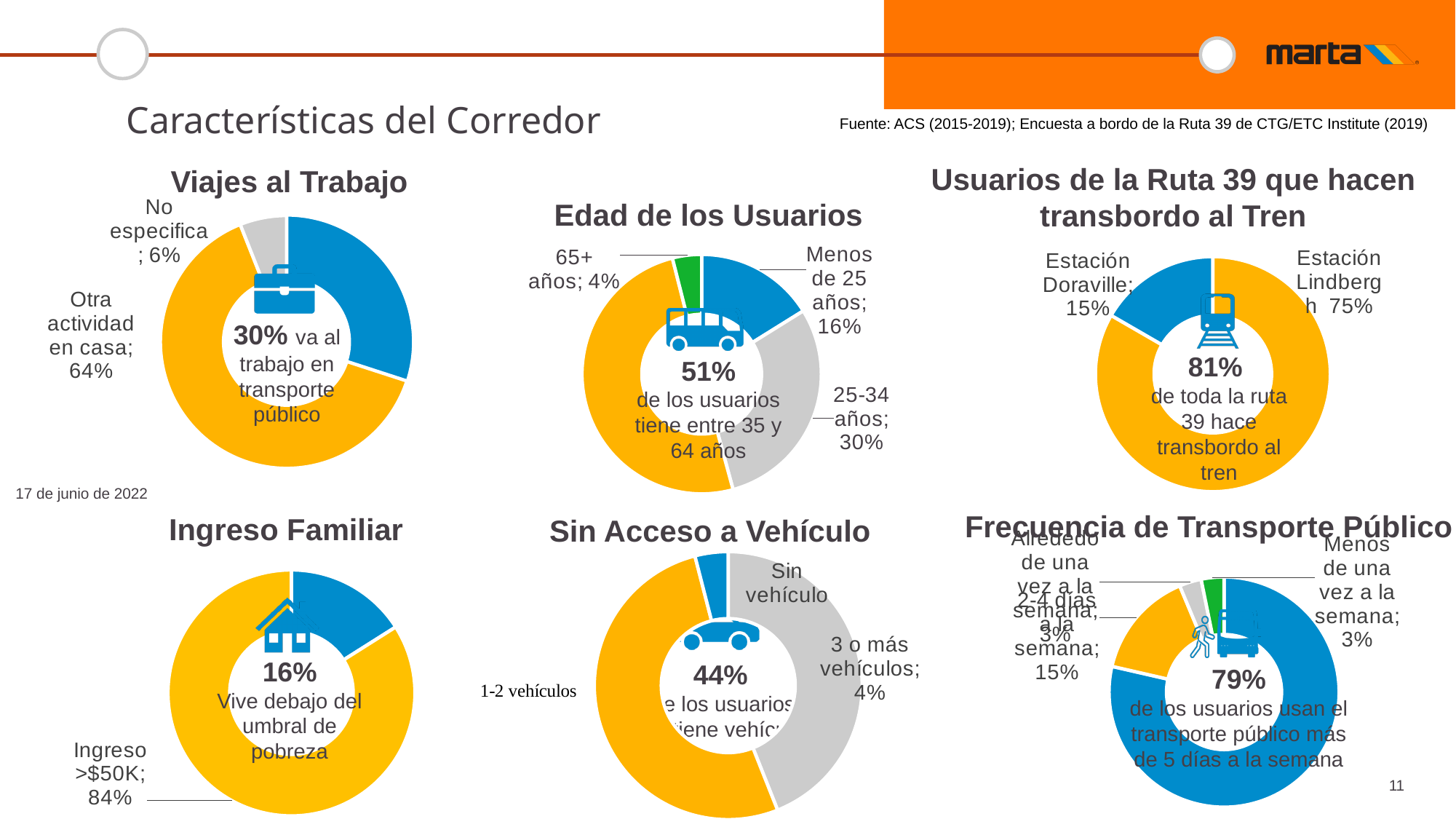
In the 'Usuarios de la Ruta 39 que hacen transbordo al Tren' chart, what percentage is shown for 'Estación Doraville'? 15% In the 'Viajes al Trabajo' chart, what percentage is shown for 'No especifica'? 6% How many slices does the 'Edad de los Usuarios' chart have? 4 In the 'Edad de los Usuarios' chart, which age group has the smallest share? 65+ años In the 'Viajes al Trabajo' chart, which category has the largest share? Otra actividad en casa In the 'Ingreso Familiar' chart, what percentage is shown for 'Ingreso >$50K'? 84% In the 'Edad de los Usuarios' chart, what percentage is shown for '25-34 años'? 30% In the 'Viajes al Trabajo' chart, what is the difference in percentage points between 'Otra actividad en casa' and 'No especifica'? 58 percentage points In the 'Edad de los Usuarios' chart, which is larger: 'Menos de 25 años' or '25-34 años'? 25-34 años In the 'Frecuencia de Transporte Público' chart, what percentage is shown for '2-4 días a la semana'? 15% In the 'Viajes al Trabajo' chart, what percentage is shown for 'Otra actividad en casa'? 64% What type of chart is used for 'Ingreso Familiar'? Doughnut chart